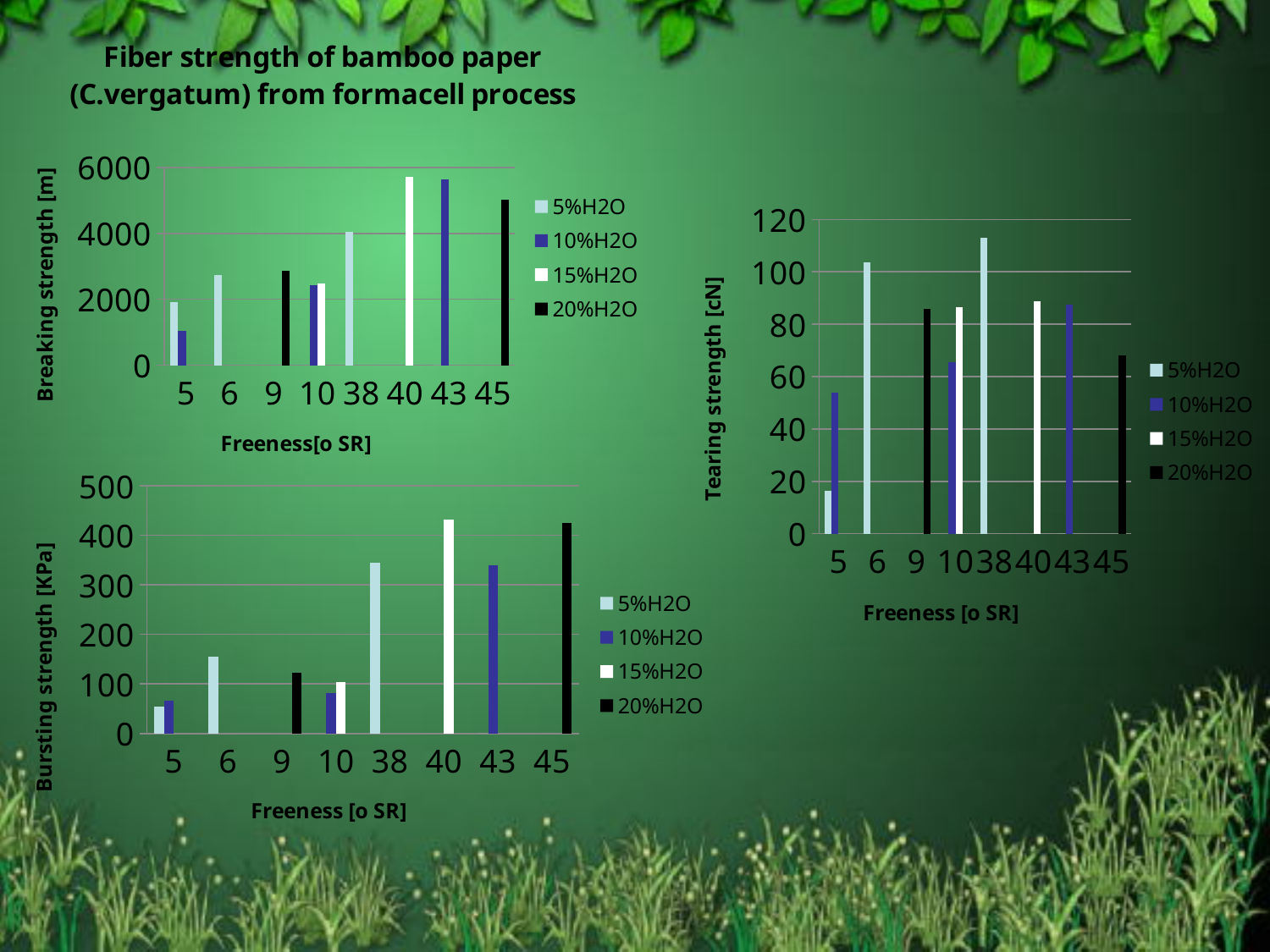
On the Breaking strength chart, how many series does the legend list? 4 On the Breaking strength chart, how many freeness categories are shown on the x axis? 8 What kind of chart is the Breaking strength chart? bar chart What is the x-axis title of the Tearing strength chart? Freeness [o SR] On the Bursting strength chart, is the value for 5%H2O at freeness 6 greater or less than 100? greater On the Tearing strength chart, is the value for 10%H2O at freeness 5 greater or less than 60? less On the Tearing strength chart, is the value for 5%H2O at freeness 38 greater or less than 100? greater On the Tearing strength chart, at which freeness is the 5%H2O bar highest? 38 On the Bursting strength chart, which is larger: 5%H2O at freeness 38 or 15%H2O at freeness 40? 15%H2O at freeness 40 On the Breaking strength chart, which bar is the lowest? 10%H2O at freeness 5